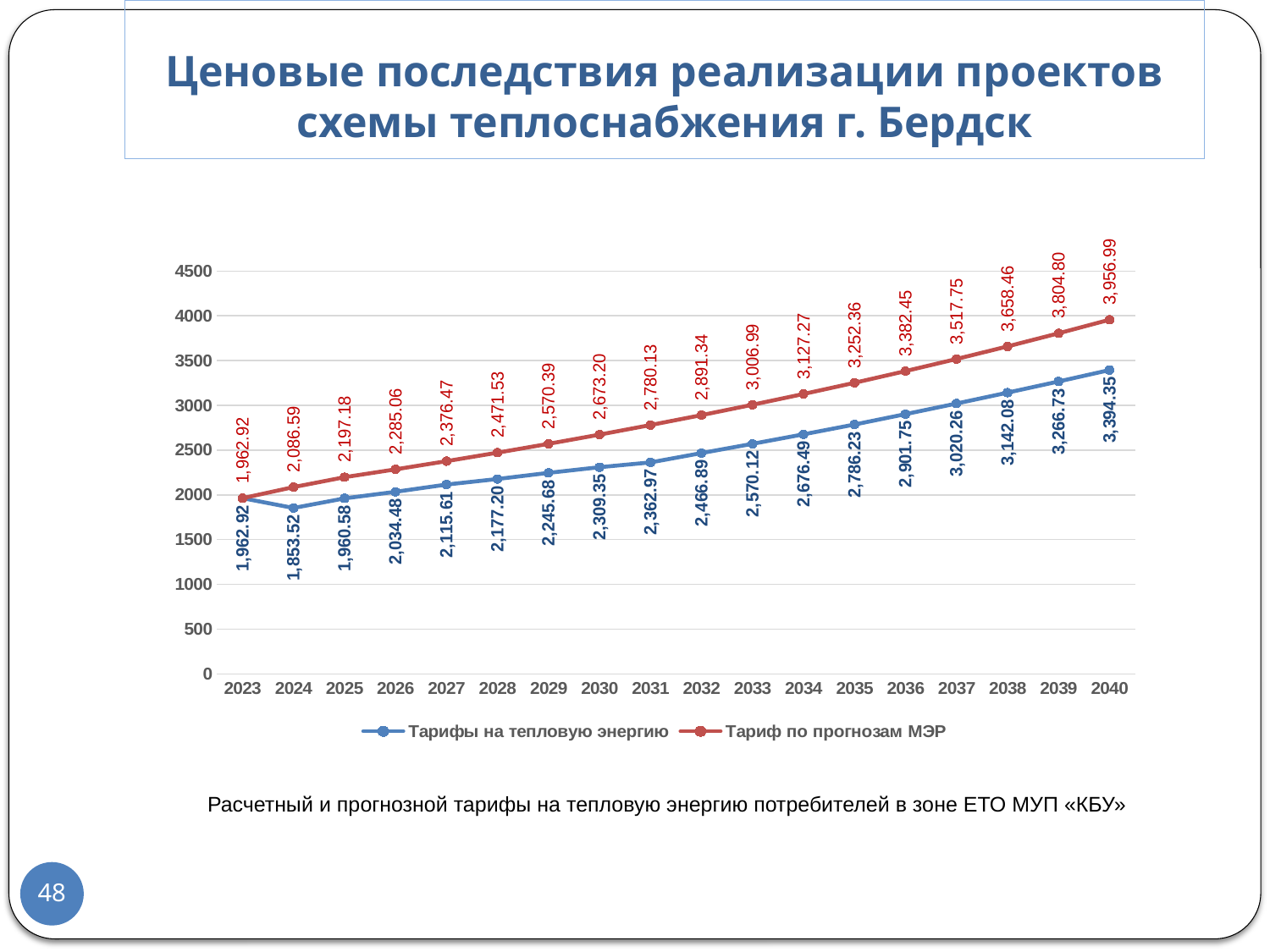
What is the value of "Тарифы на тепловую энергию" in 2030? 2,309.35 What is the difference between "Тариф по прогнозам МЭР" and "Тарифы на тепловую энергию" in 2040? 562.64 What colour is the line for "Тариф по прогнозам МЭР"? red In which year is "Тариф по прогнозам МЭР" at its highest? 2040 What is the value of "Тариф по прогнозам МЭР" in 2035? 3,252.36 How many series does the legend list? 2 What type of chart is shown on the slide? line chart How many years are plotted along the x axis? 18 Which series has the larger value in 2033, "Тарифы на тепловую энергию" or "Тариф по прогнозам МЭР"? Тариф по прогнозам МЭР What is the value of "Тарифы на тепловую энергию" in 2040? 3,394.35 In which year is "Тарифы на тепловую энергию" at its lowest? 2024 Does "Тариф по прогнозам МЭР" generally rise or fall from 2023 to 2040? rise